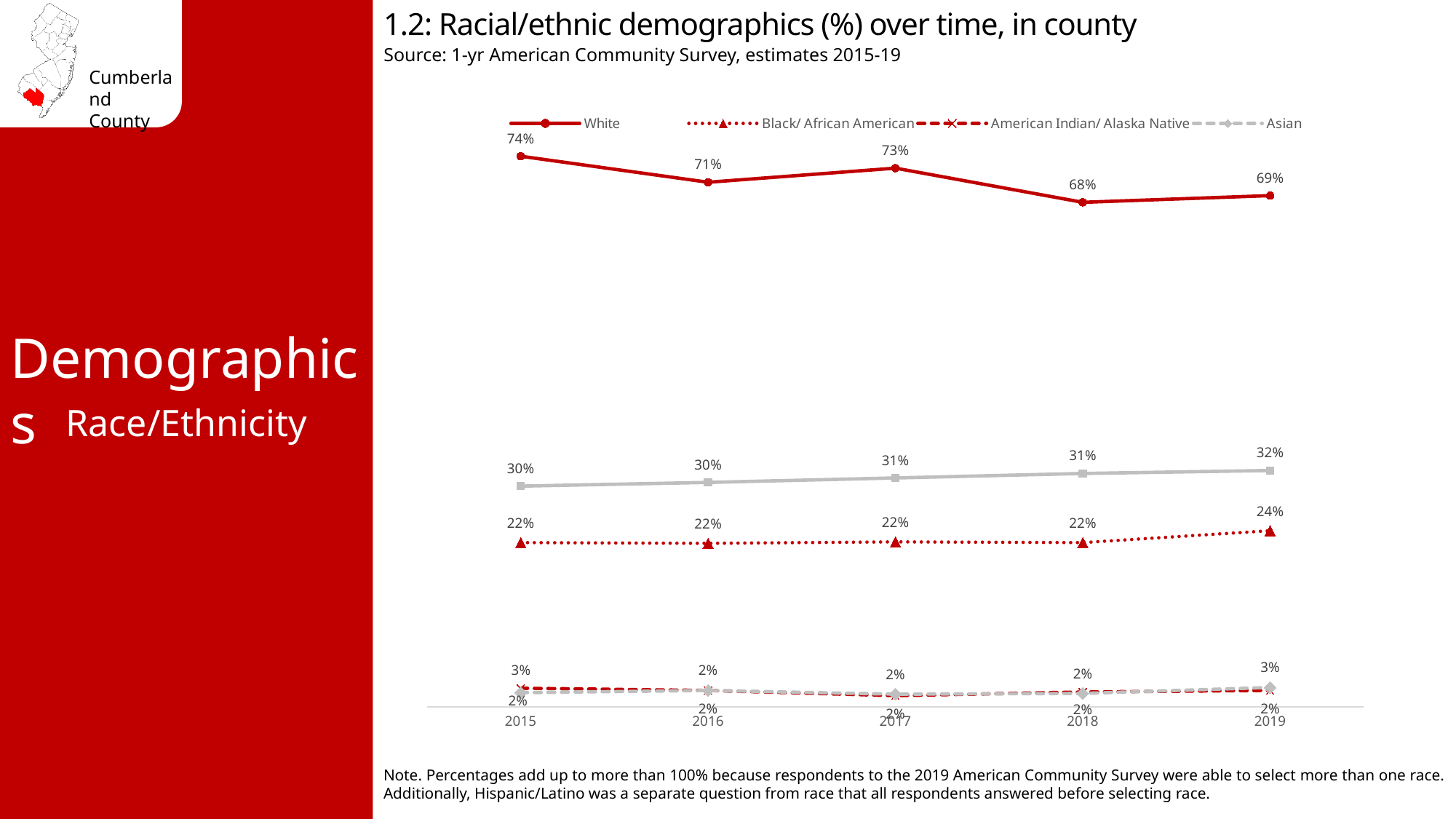
By how many percentage points did the White value change from 2015 to 2019? 5 percentage points What is the value for White in 2018? 68% What is the value for White in 2015? 74% Which year has the higher White value, 2016 or 2017? 2017 In which year is the White series at its lowest? 2018 What kind of chart is shown on the slide? line chart In which year is the White series at its highest? 2015 Does the White series generally rise or fall from 2015 to 2019? fall What is the title of the chart? 1.2: Racial/ethnic demographics (%) over time, in county What is the value for Black/ African American in 2019? 24% What is the value for Black/ African American in 2016? 22% How many years are plotted on the x axis? 5